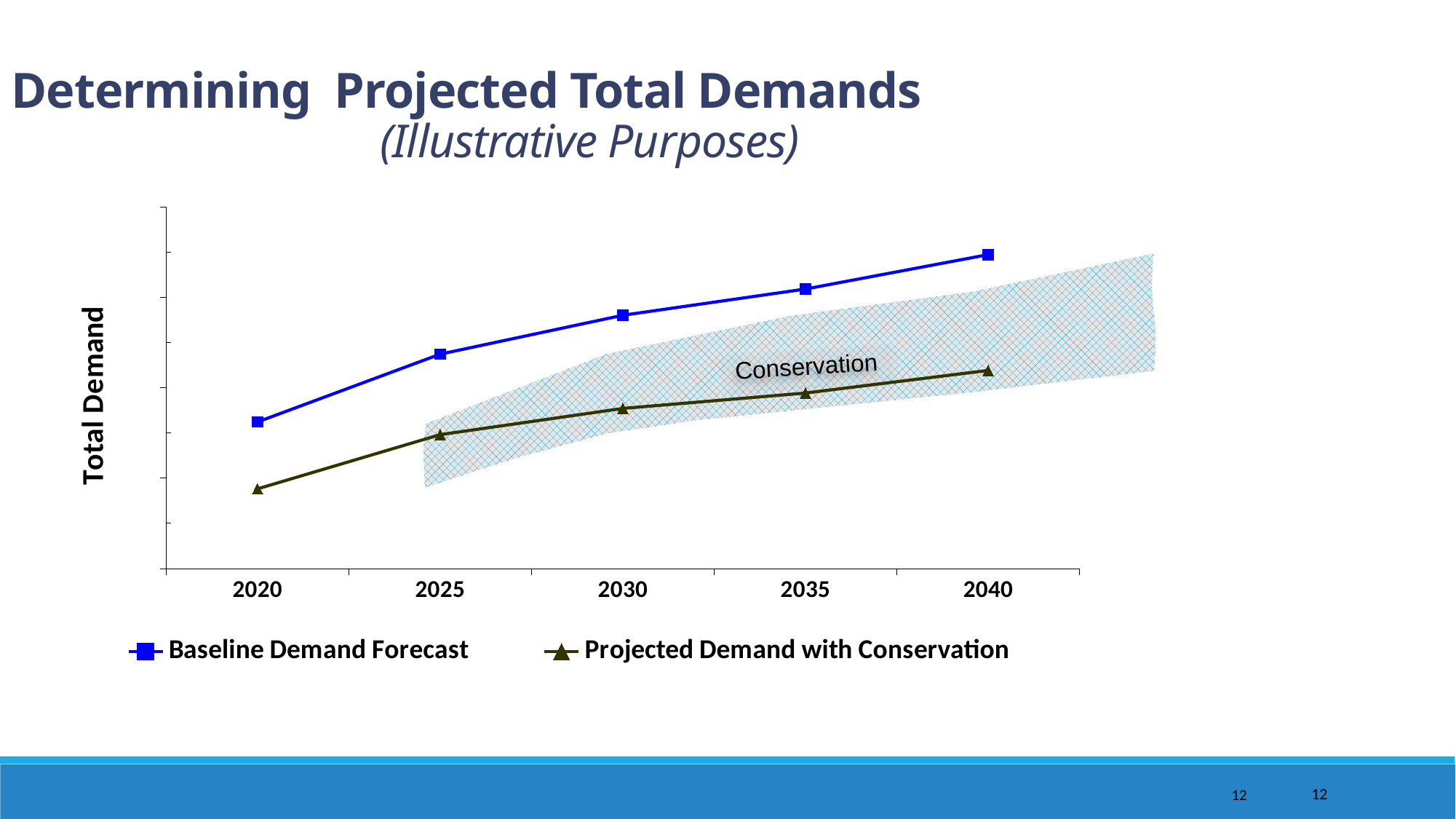
What kind of chart is shown on the slide? line chart Which series is plotted with square markers? Baseline Demand Forecast What is the first year shown on the x axis? 2020 How many years are labelled on the x axis? 5 Does the Projected Demand with Conservation rise or fall from 2020 to 2040? rise Does the Baseline Demand Forecast rise or fall from 2020 to 2040? rise Which series is plotted with triangle markers? Projected Demand with Conservation In which year is the Projected Demand with Conservation lowest? 2020 In which year is the Baseline Demand Forecast highest? 2040 In 2030, which series is higher: Baseline Demand Forecast or Projected Demand with Conservation? Baseline Demand Forecast What is the label on the y axis? Total Demand How many series does the legend list? 2